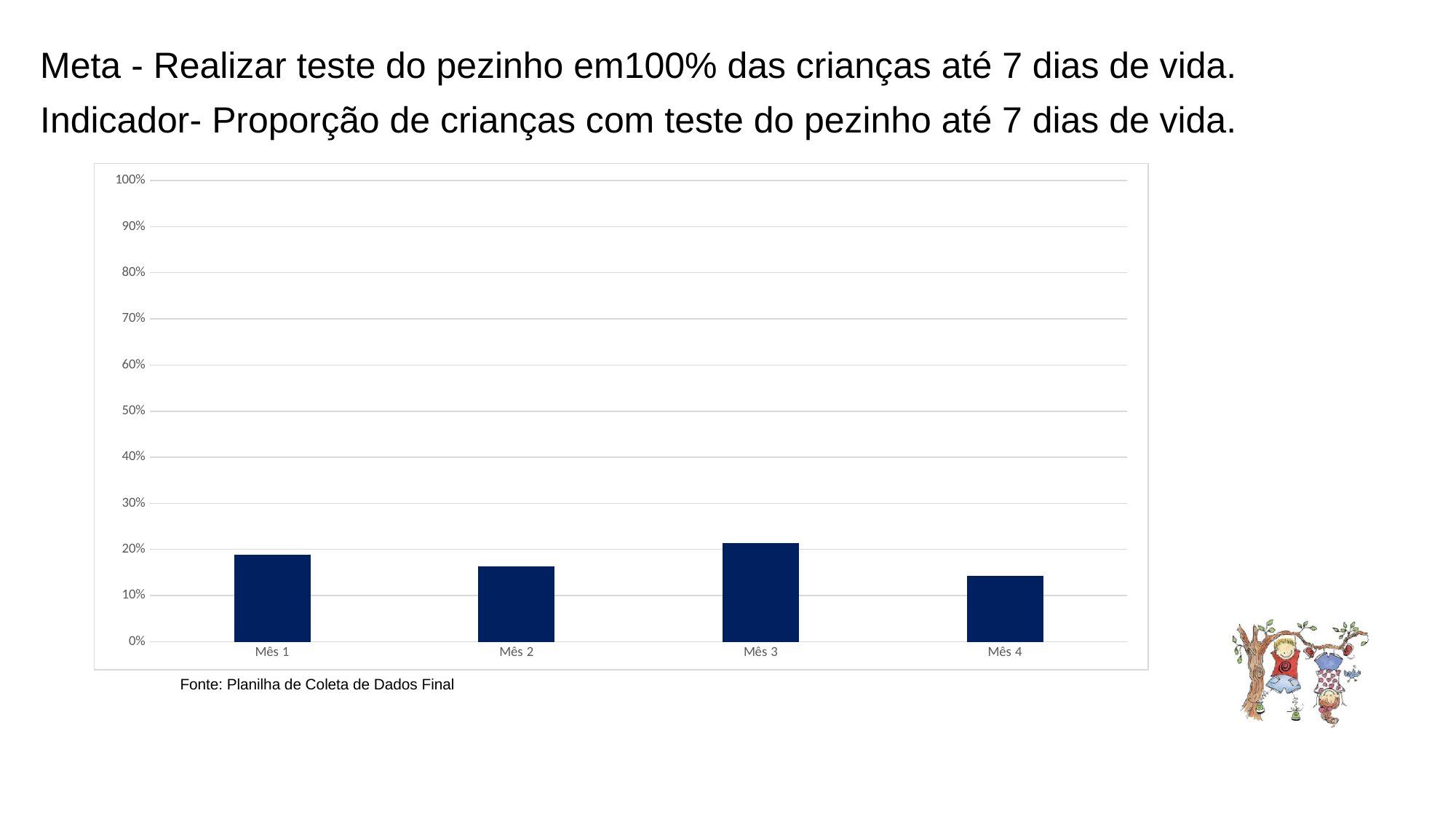
What is the highest value shown on the vertical axis of the chart? 100% How many months (categories) are plotted on the chart? 4 Which is larger, the value for Mês 1 or the value for Mês 2? Mês 1 Which is larger, the value for Mês 3 or the value for Mês 4? Mês 3 What source is cited below the chart? Planilha de Coleta de Dados Final What kind of chart is shown on the slide? bar chart Which month has the highest bar on the chart? Mês 3 Do the values rise or fall from Mês 3 to Mês 4? fall Is the value for Mês 1 greater or less than 30%? less Which month has the lowest bar on the chart? Mês 4 Is the value for Mês 2 greater or less than 20%? less Is the value for Mês 4 greater or less than 10%? greater